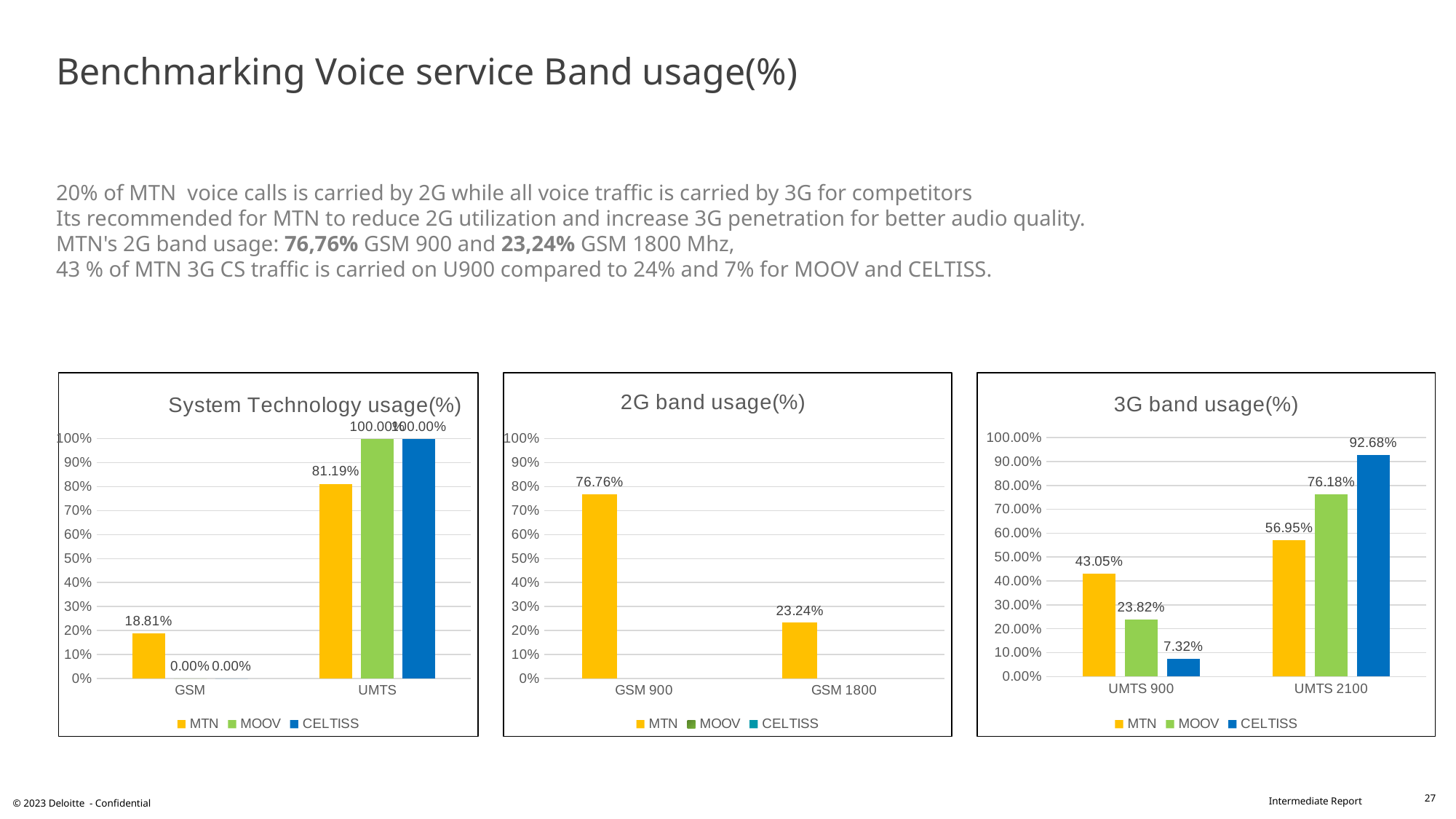
In the '3G band usage(%)' chart, what is the value for CELTISS at UMTS 900? 7.32% In the '2G band usage(%)' chart, what is the difference between the MTN values for GSM 900 and GSM 1800? 53.52% In the '3G band usage(%)' chart, what is the difference between the MOOV values for UMTS 2100 and UMTS 900? 52.36% In the 'System Technology usage(%)' chart, what is the value for MTN in the GSM category? 18.81% In the 'System Technology usage(%)' chart, what is the value for MOOV in the GSM category? 0.00% In the '2G band usage(%)' chart, what is the value for MTN at GSM 900? 76.76% In the '3G band usage(%)' chart, which series has the lowest value at UMTS 900? CELTISS In the 'System Technology usage(%)' chart, what is the value for MTN in the UMTS category? 81.19% In the '3G band usage(%)' chart, which series has the highest value at UMTS 2100? CELTISS In the '2G band usage(%)' chart, how many series does the legend list? 3 In the '3G band usage(%)' chart, is the value for MTN at UMTS 2100 larger or smaller than the value for MOOV at UMTS 2100? smaller What kind of chart is the '3G band usage(%)' chart? bar chart